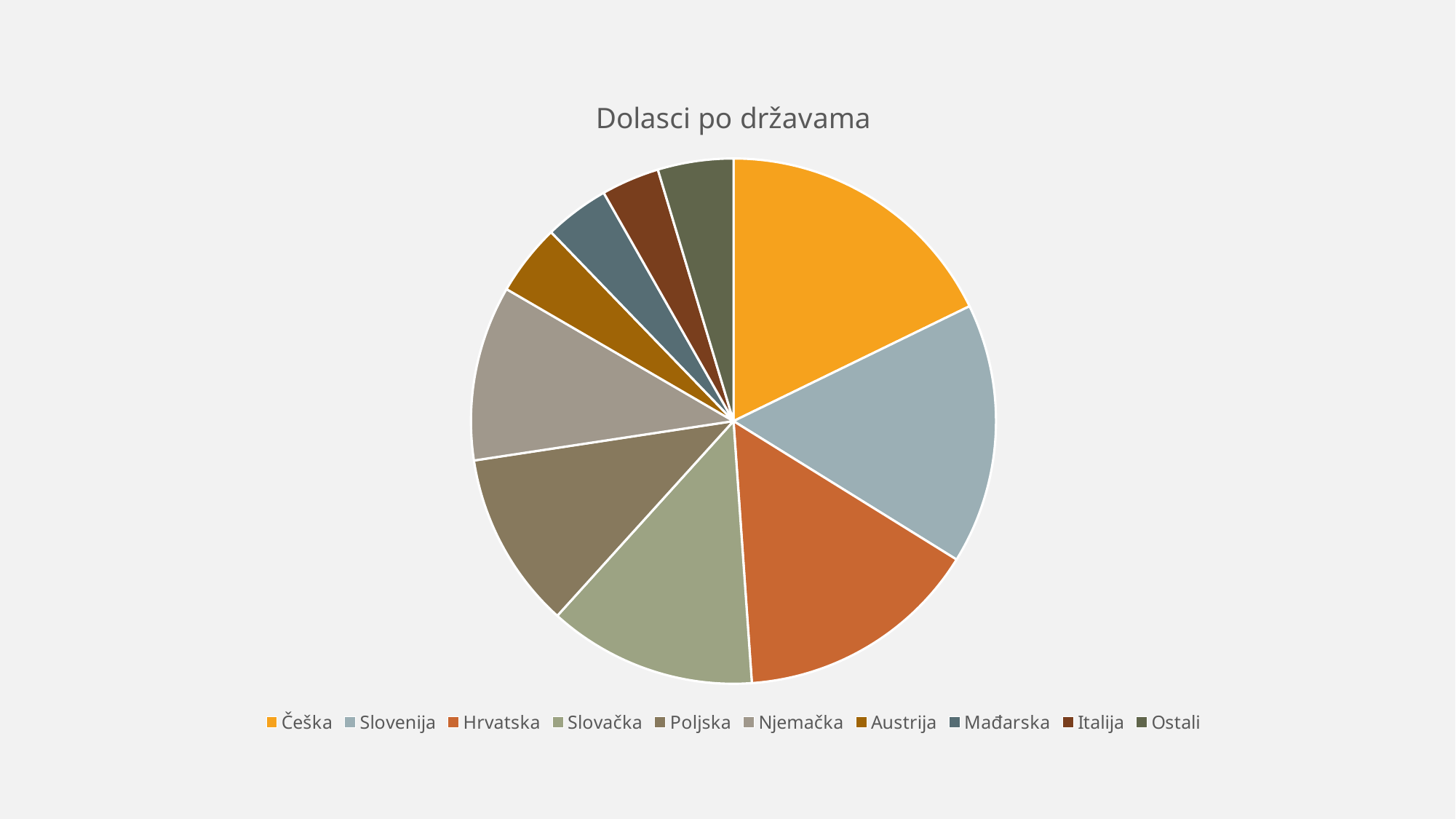
Which slice is larger, Austrija or Slovenija? Slovenija What kind of chart is shown on the slide? pie chart Which country has the largest slice of the pie? Češka Which legend entry comes last in the legend? Ostali What is the title of the chart? Dolasci po državama Which slice is larger, Italija or Hrvatska? Hrvatska How many entries does the legend list? 10 How many slices does the pie chart have? 10 What colour is the slice for Češka? orange Which slice is larger, Češka or Njemačka? Češka Which category has the smallest slice of the pie? Italija